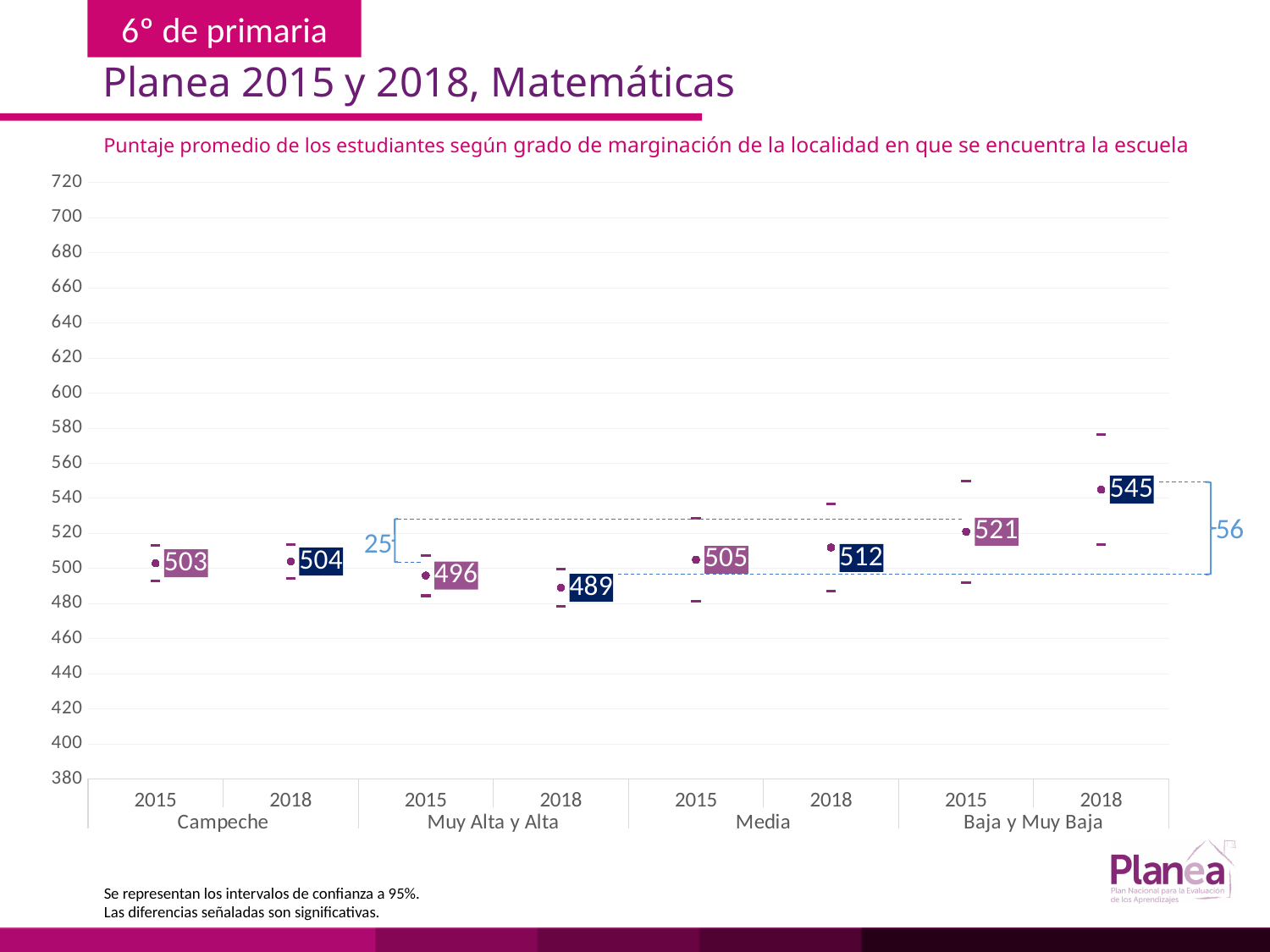
What is the subtitle of the chart? Puntaje promedio de los estudiantes según grado de marginación de la localidad en que se encuentra la escuela What is the average score for the Muy Alta y Alta marginación group in 2018? 489 Which is larger, the 2018 score for Media or the 2018 score for Campeche? Media (512) Which group and year has the lowest average score? Muy Alta y Alta, 2018 Did the score for the Muy Alta y Alta group rise or fall from 2015 to 2018? Fall What is the average score for the Baja y Muy Baja group in 2018? 545 What is the difference between the 2018 scores of the Media group and the Muy Alta y Alta group? 23 Which group and year has the highest average score? Baja y Muy Baja, 2018 How many data points are plotted in the chart? 8 What is the average score for the Media group in 2015? 505 What is the difference between the 2018 and 2015 scores for the Baja y Muy Baja group? 24 What is the average score for Campeche in 2015? 503